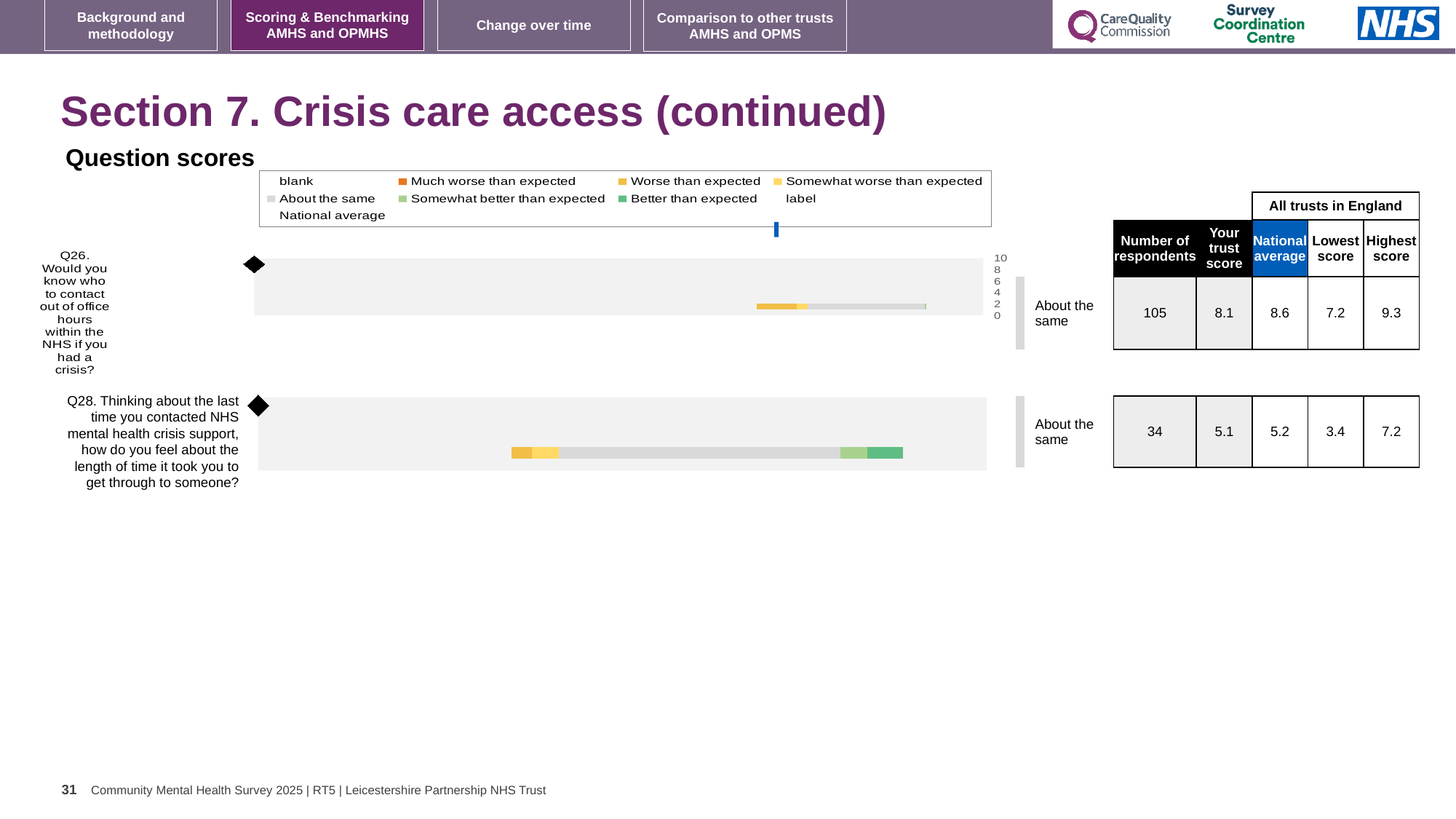
How many respondents answered Q26? 105 Which question has the higher 'Your trust score', Q26 or Q28? Q26 How many respondents answered Q28 (Thinking about the last time you contacted NHS mental health crisis support, how do you feel about the length of time it took you to get through to someone?)? 34 What is the difference between the highest score and the lowest score for Q26? 2.1 What is the highest score among all trusts in England for Q28? 7.2 What kind of chart is used to show the question scores for Q26 and Q28? bar chart For Q28, how much higher is the national average than the trust score? 0.1 What benchmark category label is shown next to the Q26 bar? About the same What is the national average score for Q26? 8.6 How many questions are plotted in the question scores chart? 2 What is the 'Your trust score' value for Q26 (Would you know who to contact out of office hours within the NHS if you had a crisis?)? 8.1 According to the legend, what does the blue marker on the chart represent? National average